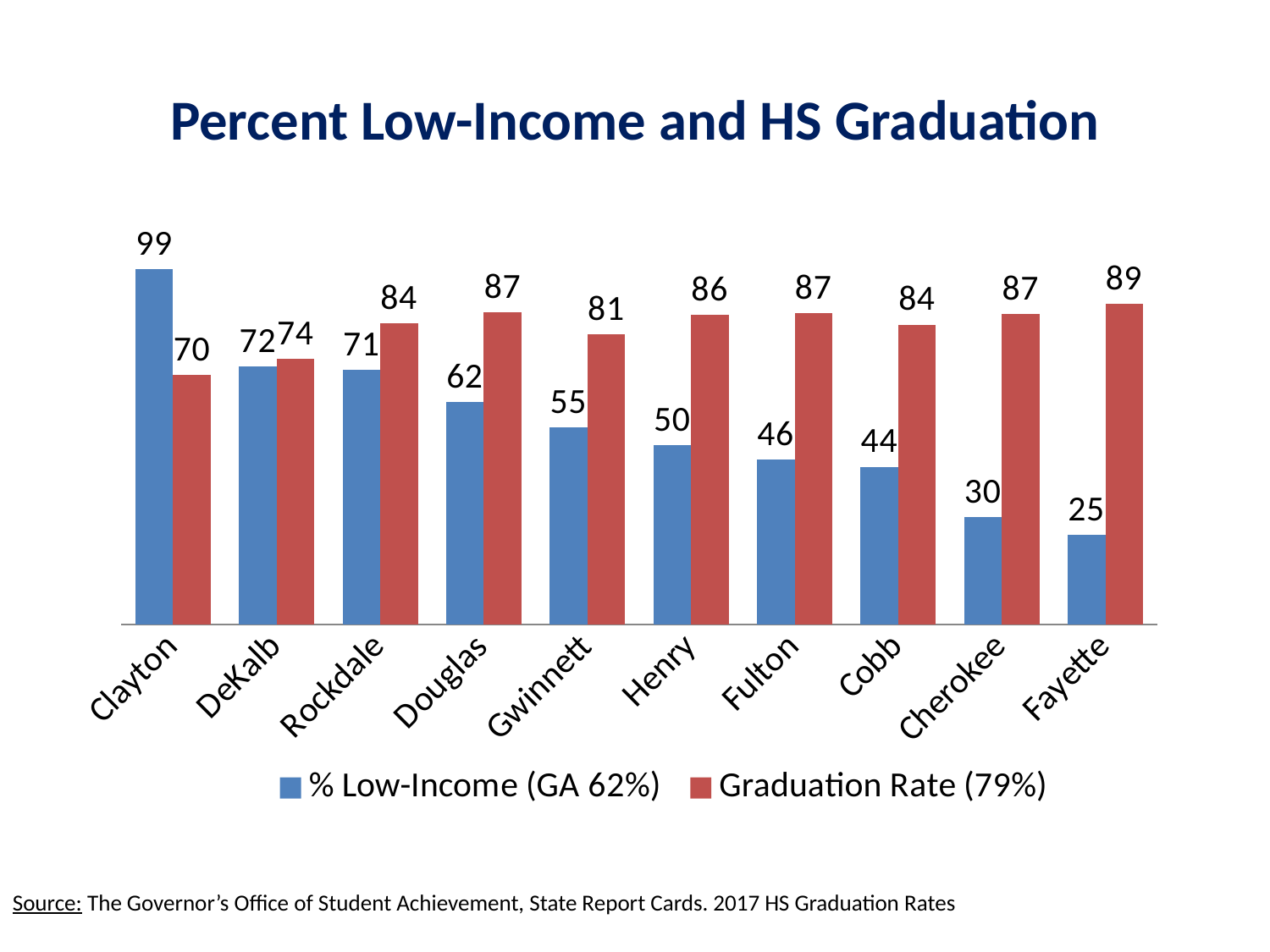
What is the % Low-Income value for Clayton? 99 Which is larger for Clayton: the % Low-Income value or the Graduation Rate? % Low-Income How many counties are shown on the x axis? 10 Which county has the highest Graduation Rate? Fayette What is the difference between the Graduation Rate and the % Low-Income value for Fayette? 64 Which county has the lowest % Low-Income value? Fayette What is the % Low-Income value for Cherokee? 30 How many series does the legend list? 2 Which county has the lowest Graduation Rate? Clayton What kind of chart is shown on the slide? Bar chart Does the % Low-Income value rise or fall from Clayton to Fayette along the x axis? Fall What is the Graduation Rate for Fayette? 89